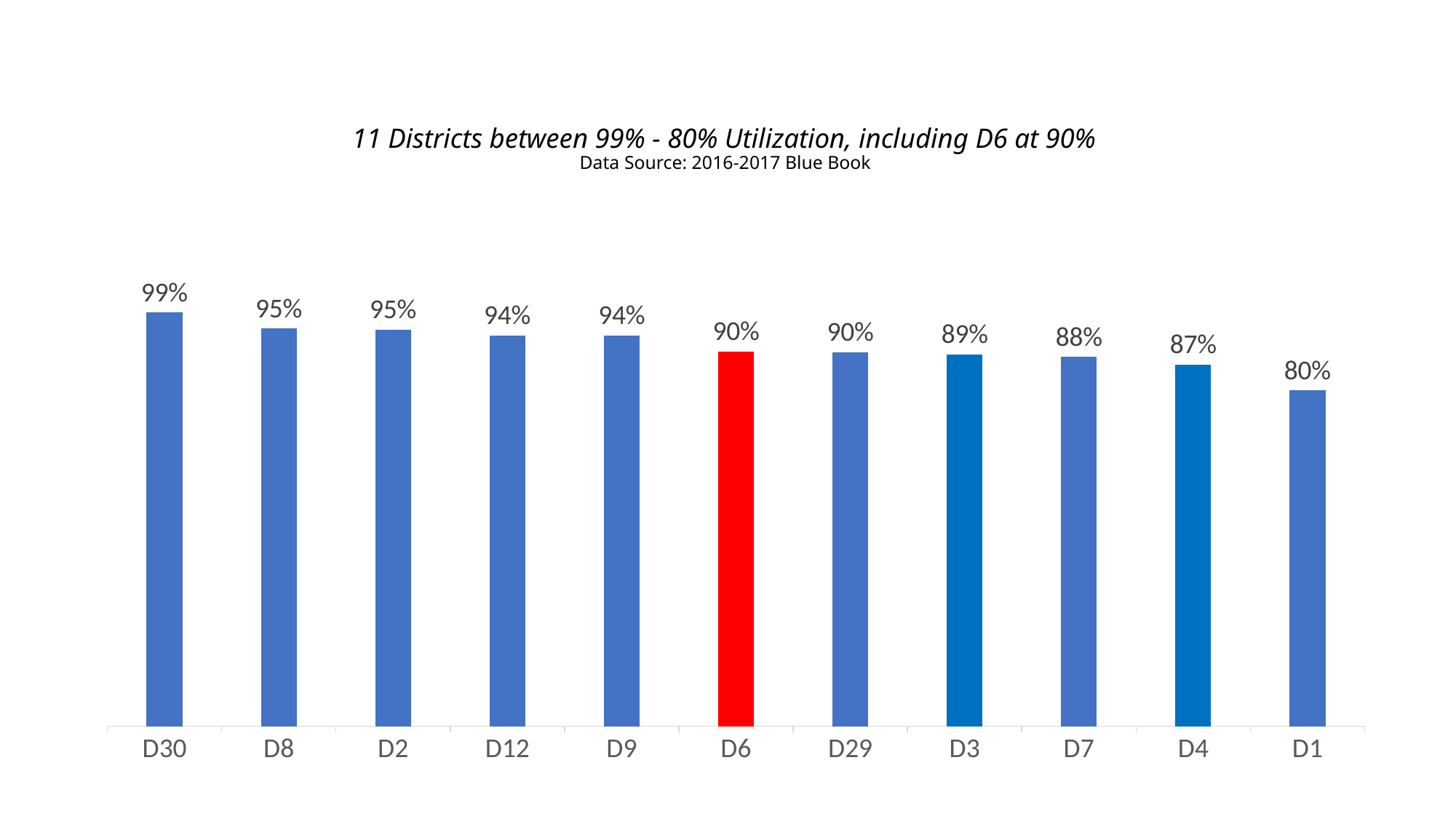
What is the difference between the utilization of D8 and D7? 7% What is the difference between the utilization of D30 and D1? 19% Which district has the lowest utilization? D1 Do the values rise or fall from left to right along the x axis? Fall Which district has the highest utilization? D30 What is the utilization value for D6? 90% What is the utilization value for D4? 87% What kind of chart is shown on the slide? Bar chart Which district's bar is coloured red? D6 What is the utilization value for D12? 94% Which has a higher utilization, D2 or D3? D2 How many districts are shown in the chart? 11